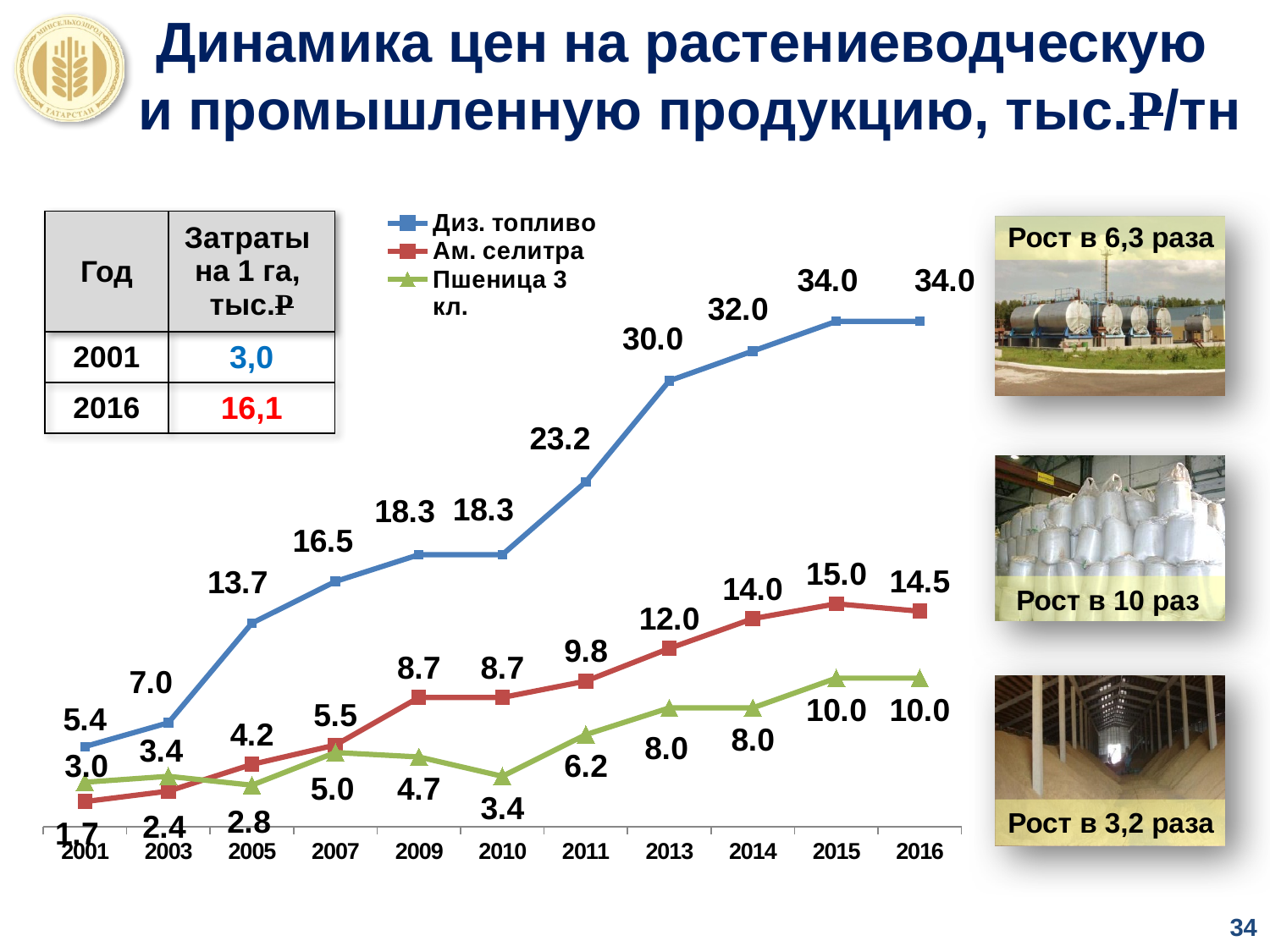
What is the value for Диз. топливо in 2011? 23.2 How many years are plotted along the x axis of the chart? 11 What is the difference between the Диз. топливо values in 2016 and 2001? 28.6 In which year does Ам. селитра reach its highest value? 2015 What type of chart is shown on the slide? line chart Which series has the larger value in 2007, Ам. селитра or Пшеница 3 кл.? Ам. селитра Does the value for Диз. топливо generally rise or fall from 2001 to 2016? rise What is the value for Ам. селитра in 2013? 12.0 How many series does the chart legend list? 3 Which series is drawn in blue in the chart? Диз. топливо In which year is the value for Пшеница 3 кл. lowest? 2005 What is the value for Пшеница 3 кл. in 2009? 4.7